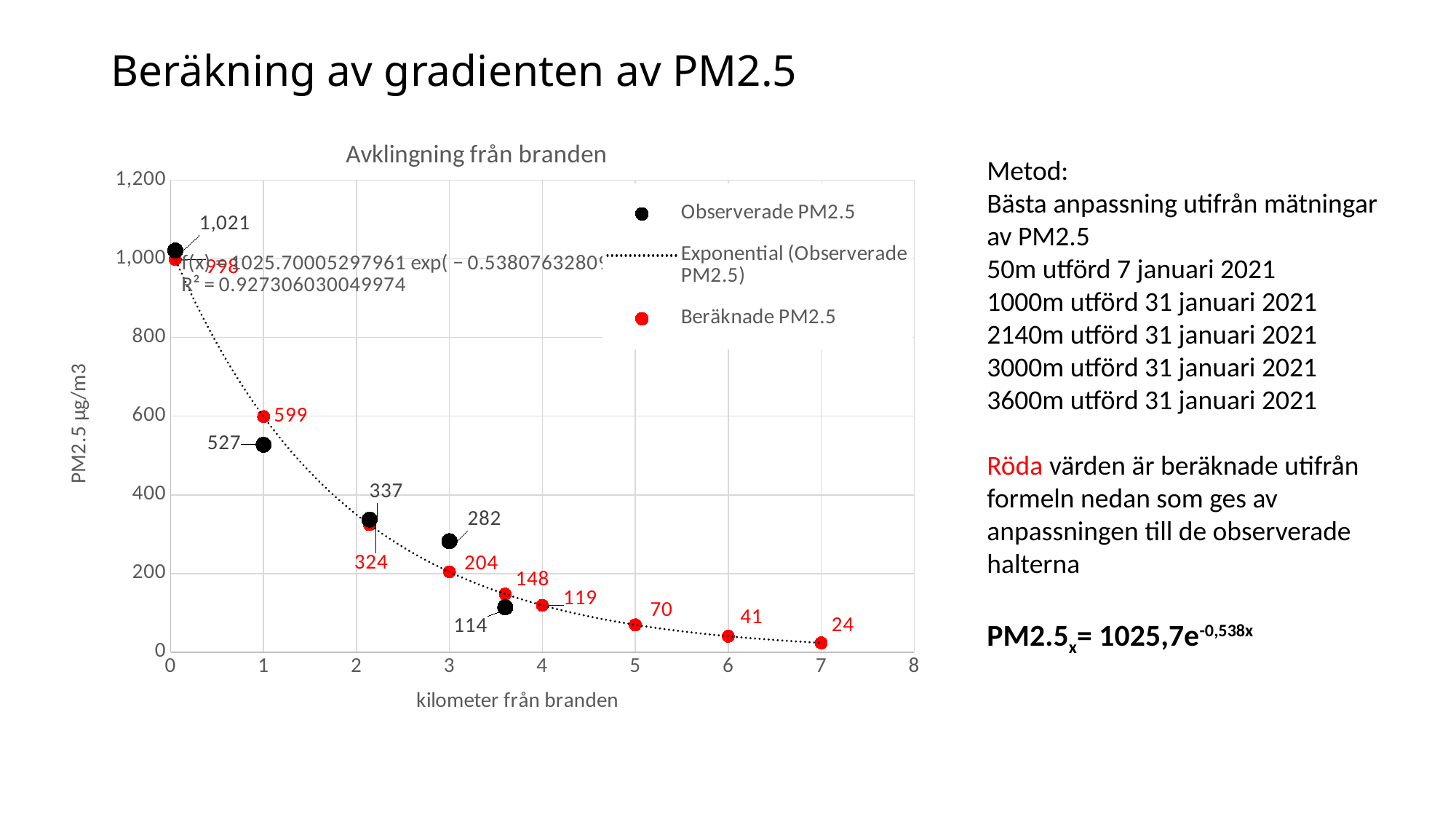
What is the lowest observed PM2.5 value (Observerade PM2.5) shown? 114 What is the title of the chart? Avklingning från branden What is the difference between the calculated value (599) and the observed value (527) at 1 kilometer? 72 How many series does the chart legend list? 3 What type of chart is shown on the slide? scatter chart Which observed PM2.5 data point has the highest value? 1,021 At 3 kilometers, which is larger: the observed PM2.5 value or the calculated PM2.5 value? observed PM2.5 (282) What is the calculated PM2.5 value (Beräknade PM2.5) at 7 kilometers from the fire? 24 How many observed PM2.5 data points (black) are plotted? 5 What is the calculated PM2.5 value (Beräknade PM2.5) at 5 kilometers from the fire? 70 Do the PM2.5 values rise or fall as the distance from the fire increases? fall What is the observed PM2.5 value (Observerade PM2.5) at 1 kilometer from the fire? 527